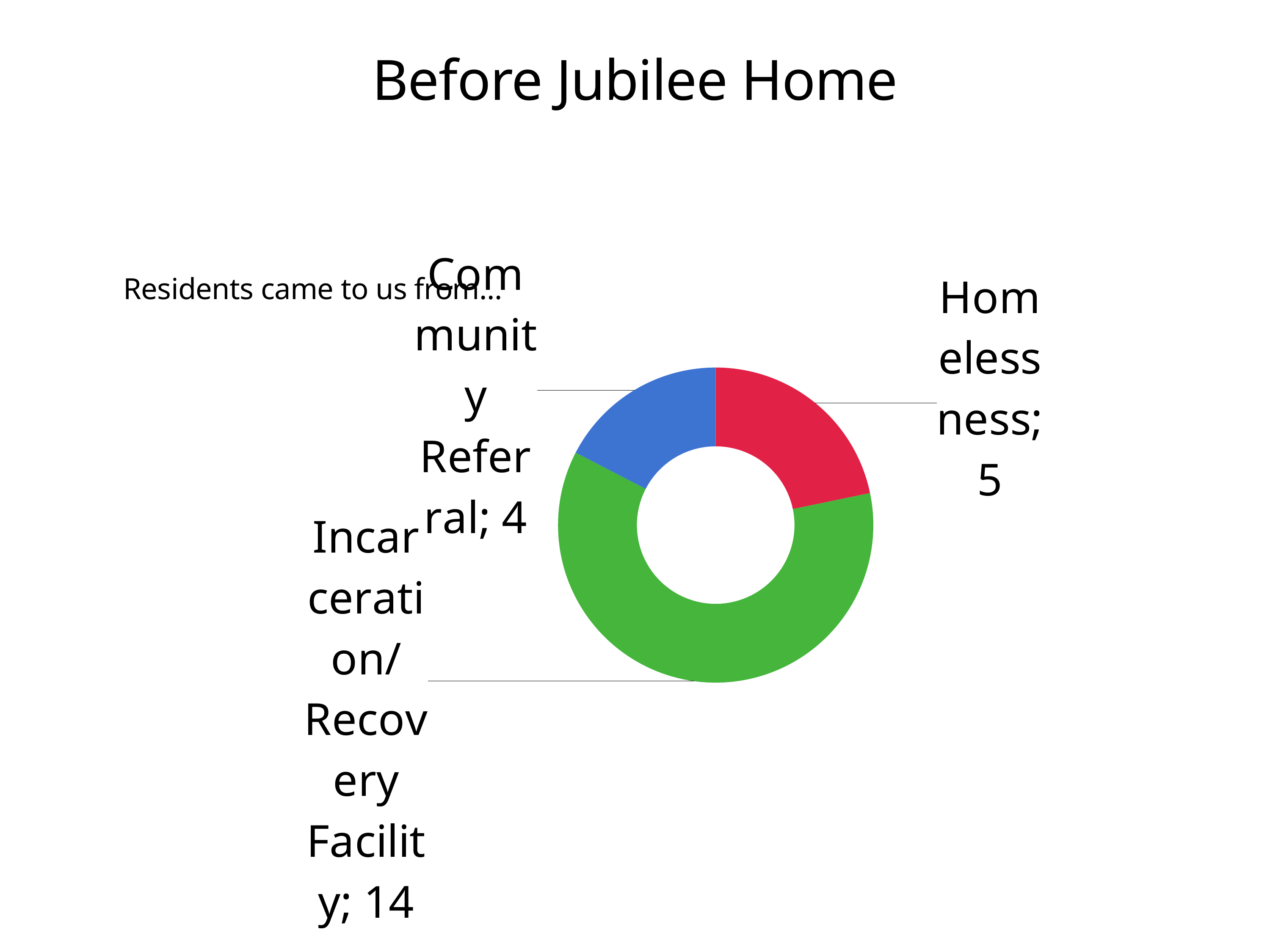
What is the value for Homelessness? 5 Which category has the highest value? Incarceration/Recovery Facility How many categories are shown in the chart? 3 What is the value for Incarceration/Recovery Facility? 14 Which is larger, the value for Homelessness or the value for Incarceration/Recovery Facility? Incarceration/Recovery Facility What is the total of all the values in the chart? 23 Which category has the lowest value? Community Referral What is the difference between the values for Homelessness and Community Referral? 1 What is the value for Community Referral? 4 What is the title of the slide? Before Jubilee Home What kind of chart is shown on the slide? Doughnut chart What is the difference between the values for Incarceration/Recovery Facility and Homelessness? 9